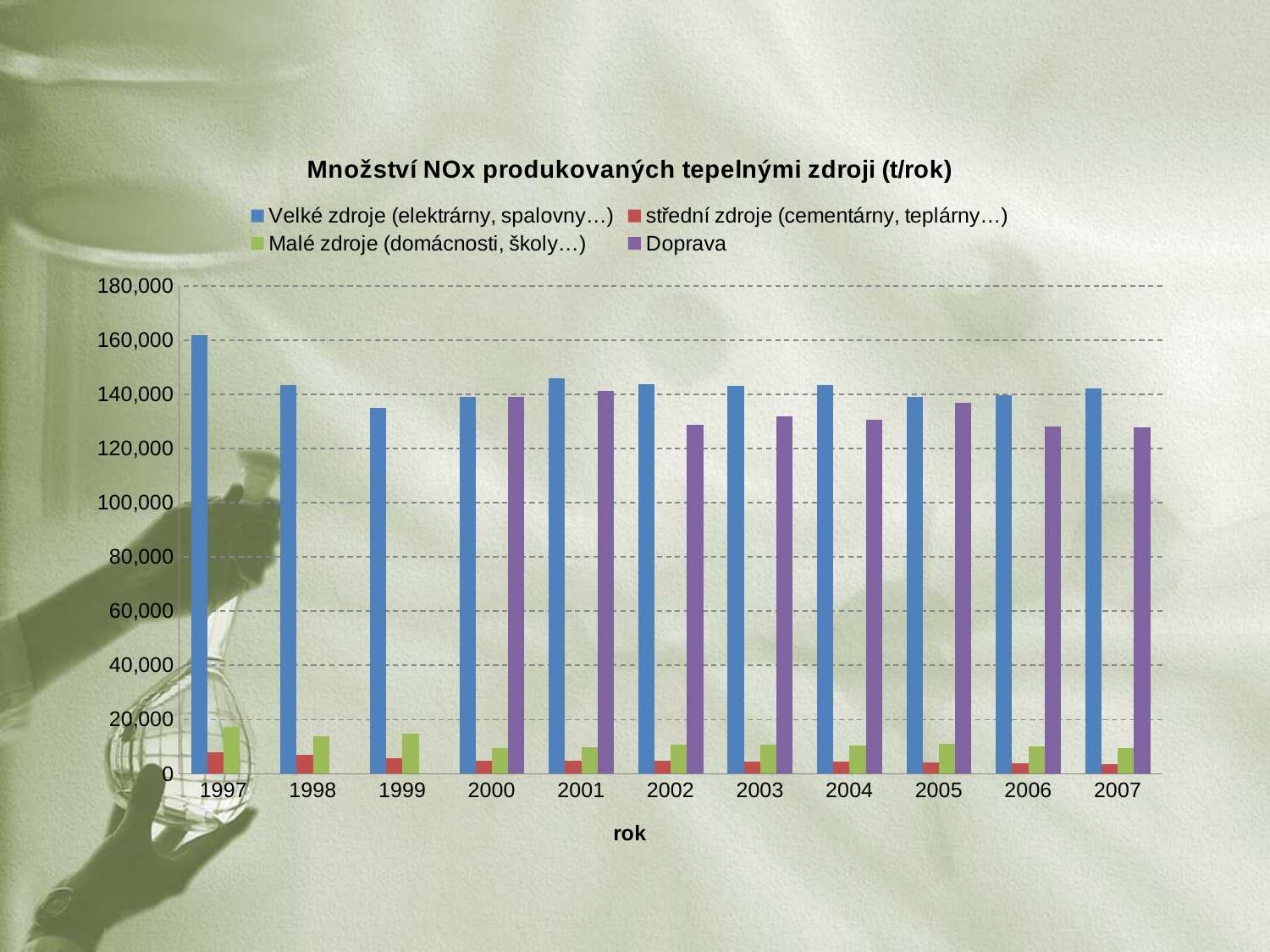
In which year is the value for Velké zdroje (elektrárny, spalovny…) highest? 1997 Is the value for střední zdroje (cementárny, teplárny…) in 2007 greater or less than 20,000? less Is the value for Doprava in 2002 greater or less than 140,000? less Do the values for střední zdroje (cementárny, teplárny…) rise or fall from 1997 to 2007? fall How many years are shown on the x axis? 11 What is the title of the chart? Množství NOx produkovaných tepelnými zdroji (t/rok) In which year is the value for Velké zdroje (elektrárny, spalovny…) lowest? 1999 How many series does the legend list? 4 In 2002, which is larger: Velké zdroje (elektrárny, spalovny…) or Doprava? Velké zdroje (elektrárny, spalovny…) Is the value for Velké zdroje (elektrárny, spalovny…) in 1997 greater or less than 140,000? greater What kind of chart is shown on the slide? bar chart What is the label of the x axis? rok